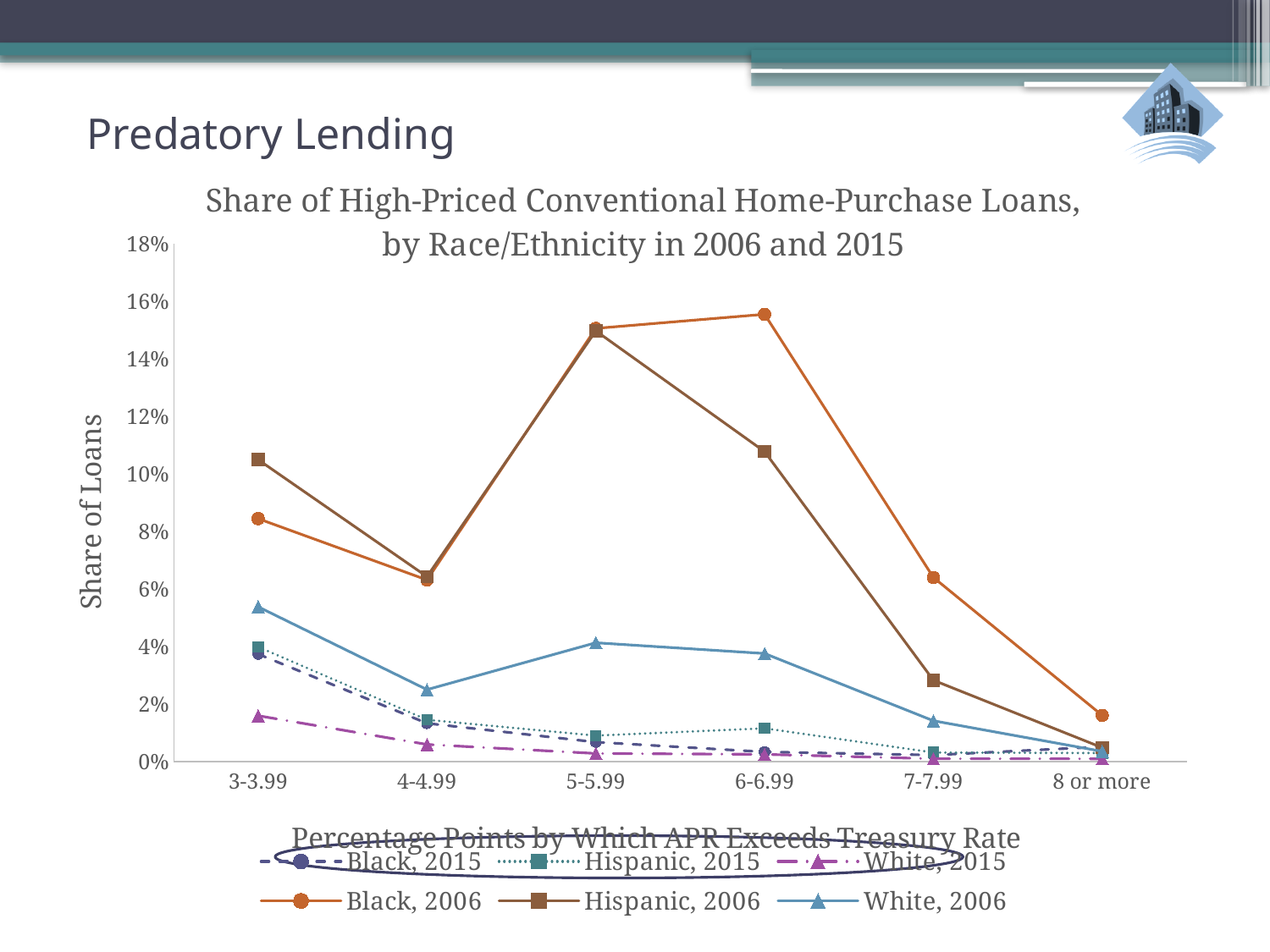
Which series has the highest value at the 3-3.99 category? Hispanic, 2006 Is the value for Hispanic, 2006 at 7-7.99 greater or less than 4%? less Do the values for White, 2015 rise or fall from 3-3.99 to 8 or more? fall What type of chart is shown on the slide? line chart How many categories are shown on the x axis? 6 Is the value for White, 2006 at 3-3.99 greater or less than 4%? greater Which series has the lowest value at the 3-3.99 category? White, 2015 What is the title of the y axis? Share of Loans For the Hispanic, 2006 series, which category has the highest value? 5-5.99 At the 6-6.99 category, which is larger: Black, 2006 or Hispanic, 2006? Black, 2006 Is the value for Black, 2006 at 6-6.99 greater or less than 14%? greater How many series does the legend list? 6